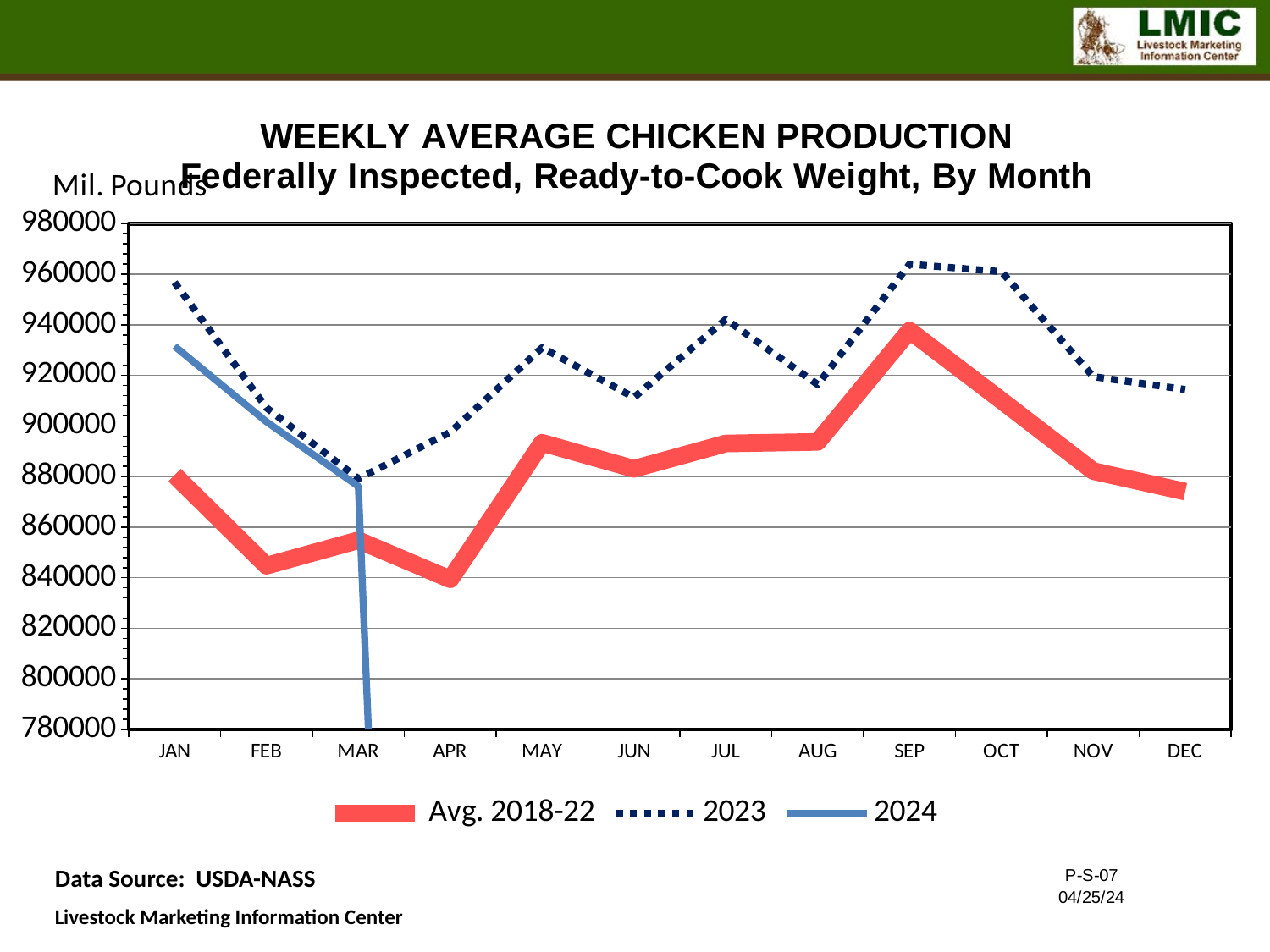
In which month is the Avg. 2018-22 series at its highest? SEP What unit label is shown on the y axis? Mil. Pounds Is the 2024 value for JAN greater or less than 920000? greater In which month is the Avg. 2018-22 series at its lowest? APR In which month is the 2023 series at its lowest? MAR How many series does the legend list? 3 Does the 2023 series rise or fall from SEP to DEC? fall In JAN, which is larger: the 2023 value or the Avg. 2018-22 value? 2023 How many months are shown along the x axis? 12 Is the 2023 value for JAN greater or less than 940000? greater What kind of chart is shown on the slide? line chart Is the Avg. 2018-22 value for APR greater or less than 860000? less